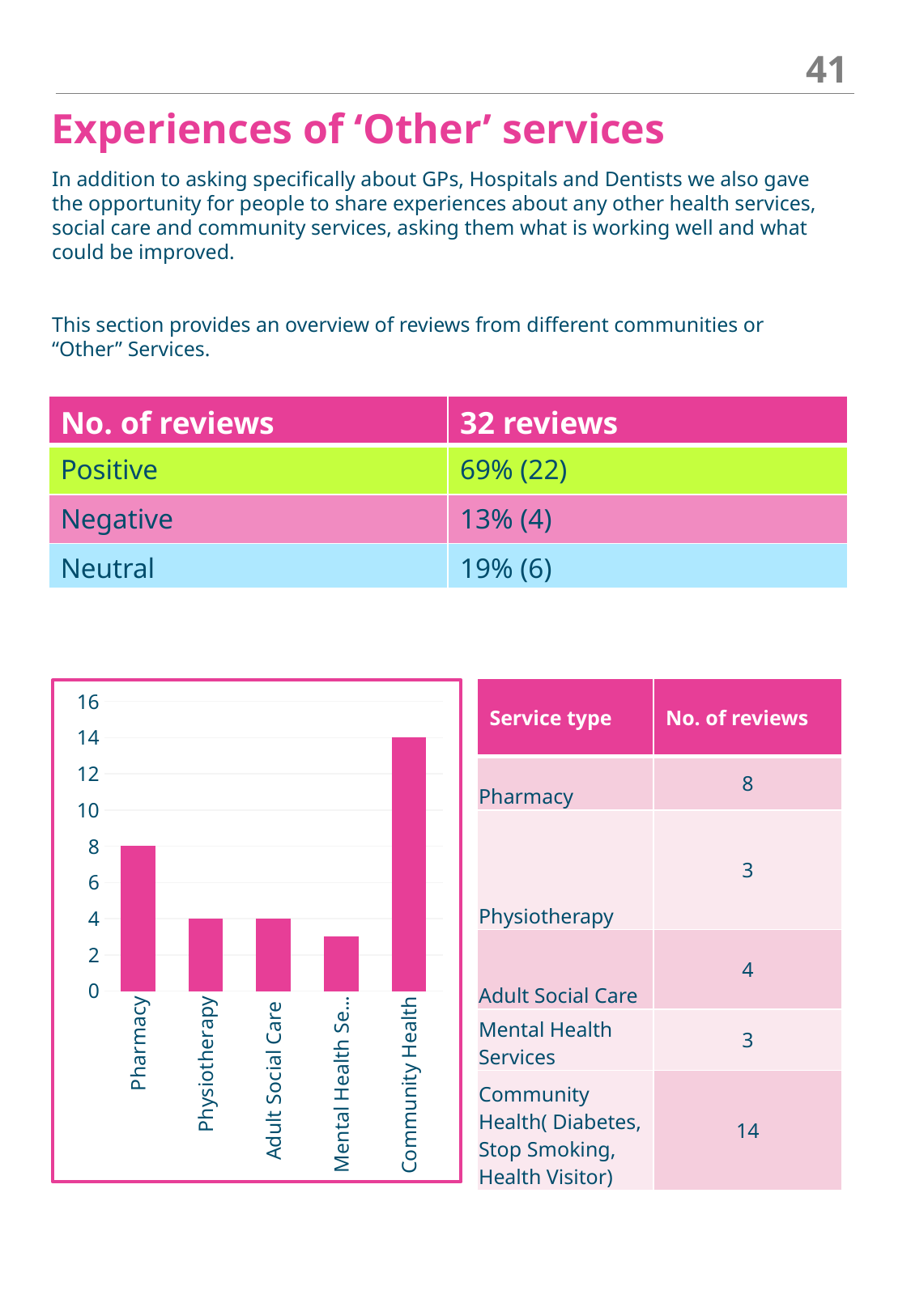
Is the value for Community Health greater or less than 12? greater What colour are the bars in the chart? pink What is the value of the bar for Pharmacy? 8 Which bar is taller, Pharmacy or Adult Social Care? Pharmacy What is the value of the bar for Community Health? 14 Is the value for Mental Health Se... greater or less than 4? less What type of chart is shown on the slide? bar chart How many service categories are plotted in the bar chart? 5 What is the difference between the bars for Community Health and Pharmacy? 6 What is the value of the bar for Adult Social Care? 4 Which service has the lowest bar in the chart? Mental Health Services Which service has the highest bar in the chart? Community Health